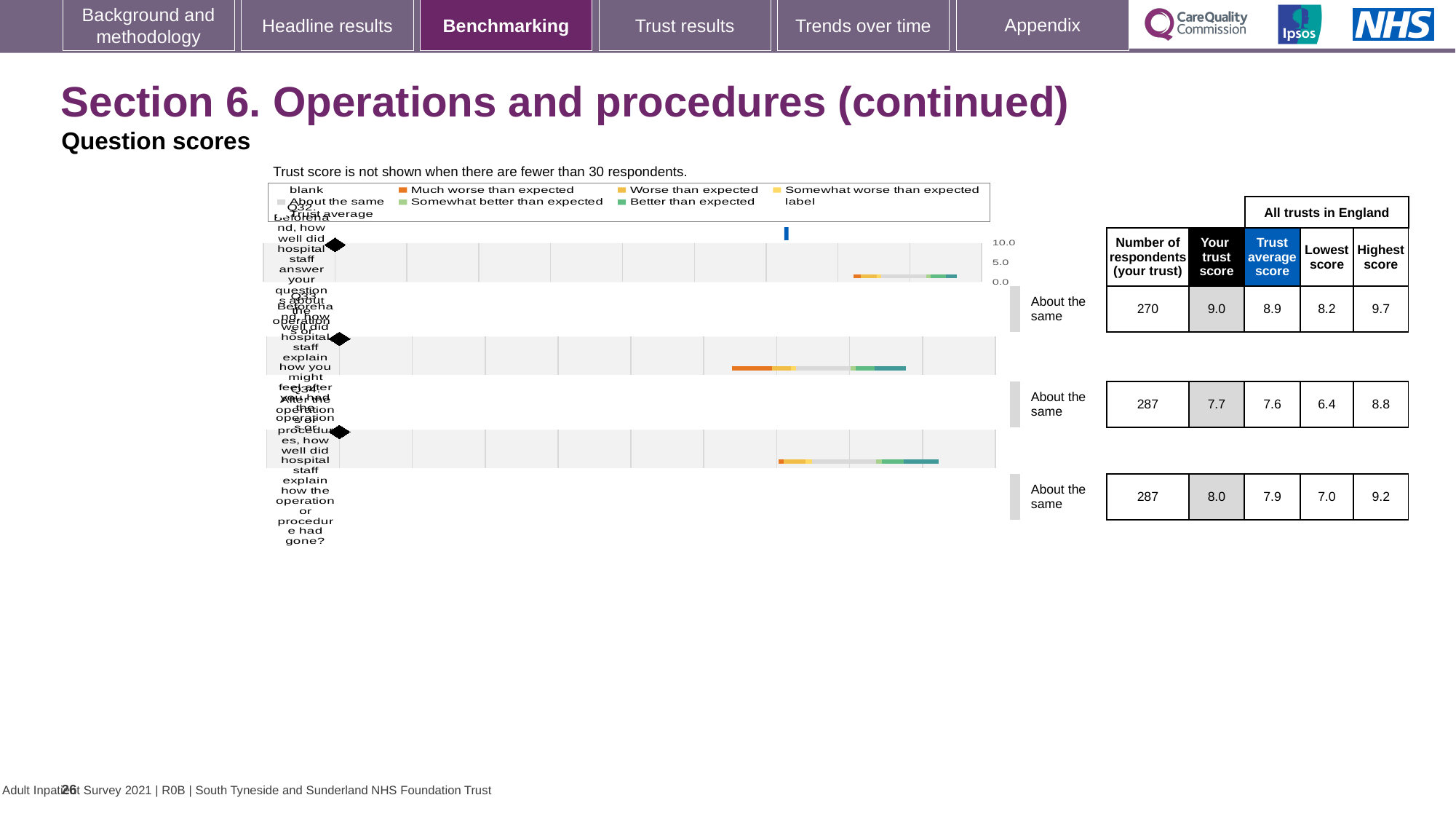
What is the number of respondents for the second question row (Q33)? 287 Which of the three question rows has the highest 'Your trust score'? Q32 (first row), 9.0 What is the trust average score for the third question row (Q34)? 7.9 What is the lowest score across all trusts in England for the second question row (Q33)? 6.4 What type of chart is used to show the question scores? Bar chart What is the 'Your trust score' for the first question row (Q32) in the table next to the chart? 9.0 Which of the three question rows has the lowest 'Your trust score'? Q33 (second row), 7.7 What is the difference between the highest score and the lowest score for the third question row (Q34)? 2.2 What benchmark category is shown for each of the three question rows? About the same What is the highest score across all trusts in England for the first question row (Q32)? 9.7 Is the trust score for the first question row (Q32) larger or smaller than the trust average score for that row? larger How many question rows are shown in the chart? 3